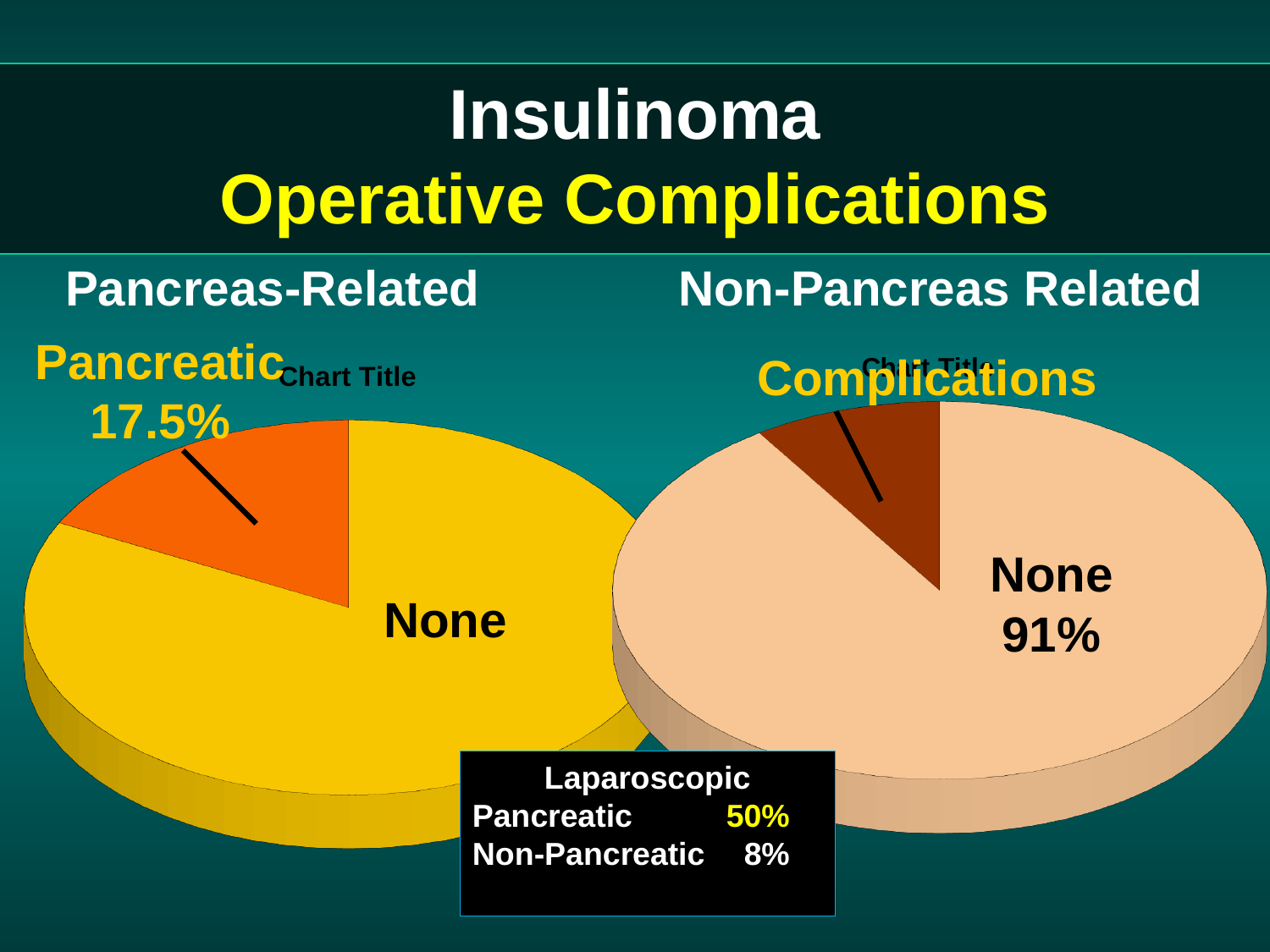
How many slices does the Non-Pancreas Related pie chart on the right have? 2 In the Pancreas-Related chart on the left, what colour is the Pancreatic slice? Orange How many slices does the Pancreas-Related pie chart on the left have? 2 In the Non-Pancreas Related chart on the right, which slice is the smallest? Complications In the Pancreas-Related chart on the left, which slice is the largest? None In the Non-Pancreas Related chart on the right, what percentage is shown for the None slice? 91% In the Pancreas-Related chart on the left, what percentage is shown for the Pancreatic slice? 17.5% In the Pancreas-Related chart on the left, which slice is the smallest? Pancreatic What kind of chart is the Pancreas-Related chart on the left? Pie chart In the Non-Pancreas Related chart on the right, which slice is the largest? None What kind of chart is the Non-Pancreas Related chart on the right? Pie chart In the Pancreas-Related chart on the left, which slice is larger, None or Pancreatic? None